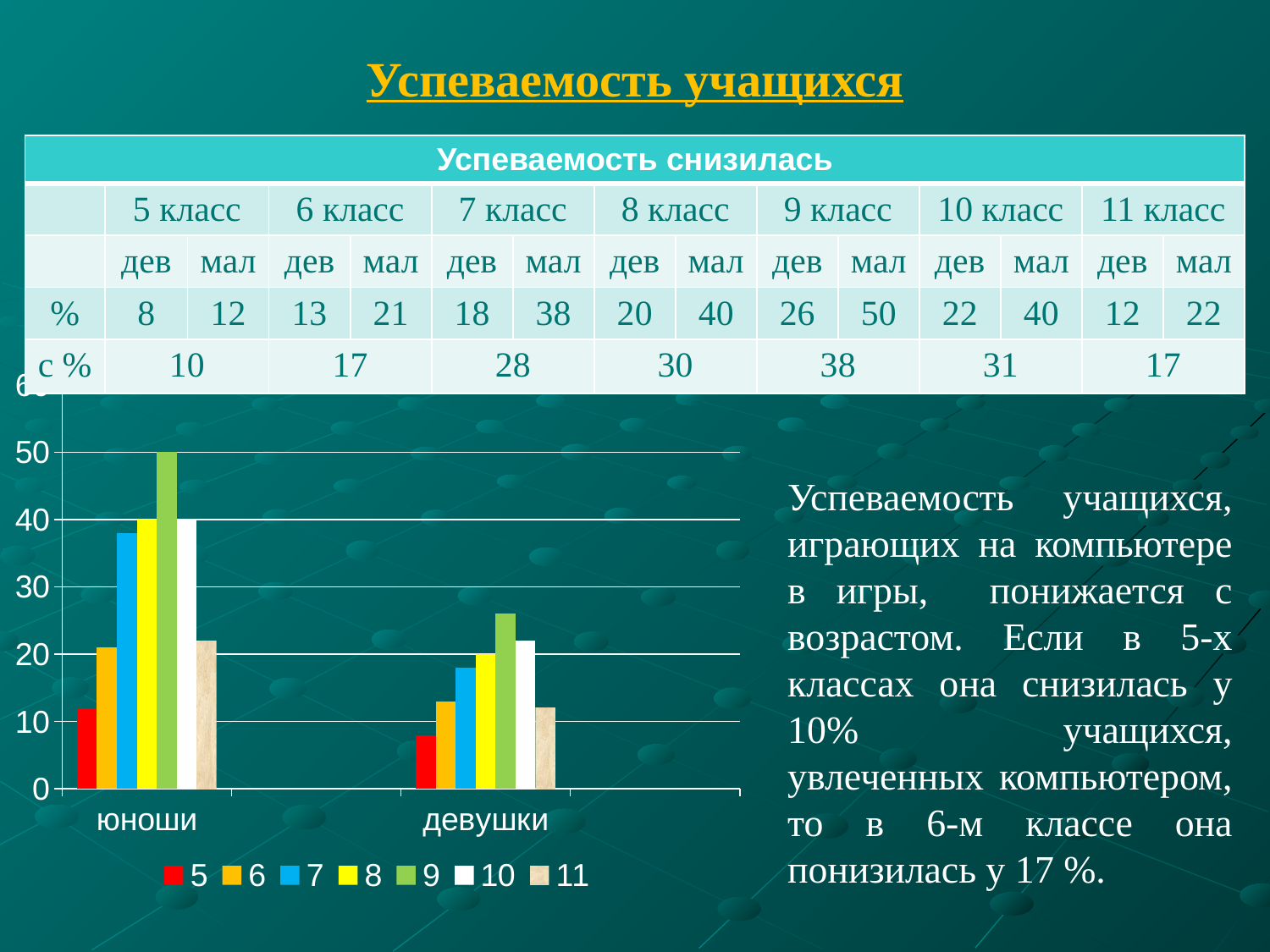
What kind of chart is shown on the slide? bar chart What is the value of series 8 for юноши? 40 How many series does the chart legend list? 7 What is the value of series 8 for девушки? 20 Which series has the lowest value for юноши? 5 For series 7, which category has the larger value, юноши or девушки? юноши How many categories are shown on the x axis of the chart? 2 Which series has the lowest value for девушки? 5 What is the value of series 9 for юноши? 50 Is the value of series 7 for юноши greater or less than 30? greater Is the value of series 11 for девушки greater or less than 20? less Which series has the highest value for юноши? 9